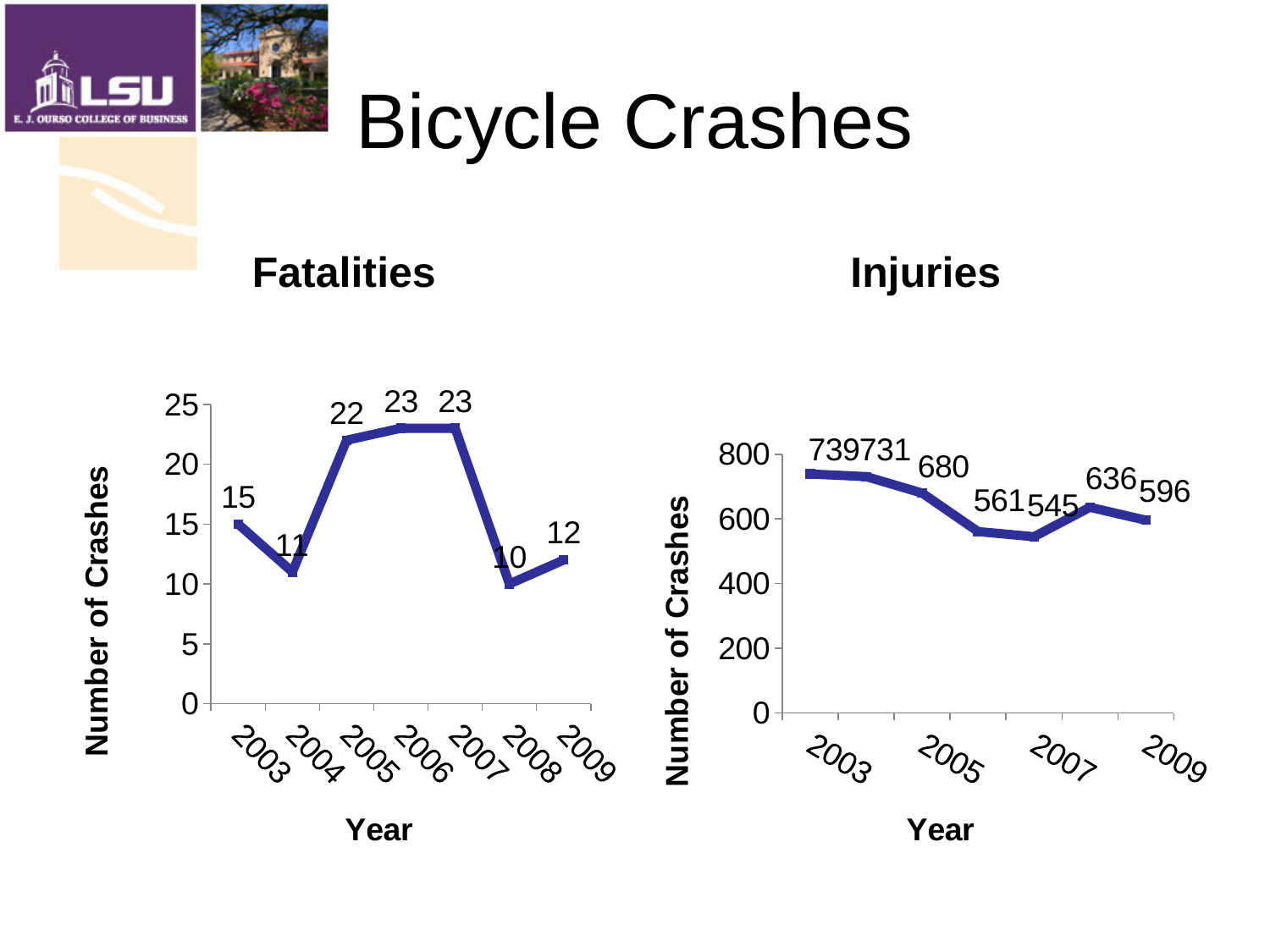
On the Fatalities chart, what is the difference between the number of crashes in 2006 and in 2008? 13 On the Fatalities chart, what is the number of crashes in 2008? 10 On the Fatalities chart, which year has the lowest number of crashes? 2008 On the Injuries chart, what is the number of crashes in 2009? 596 On the Fatalities chart, which year has more crashes, 2003 or 2009? 2003 On the Injuries chart, which year has the lowest number of crashes? 2007 On the Injuries chart, what is the difference between the number of crashes in 2003 and in 2009? 143 How many years are plotted on the Fatalities chart? 7 On the Injuries chart, what is the number of crashes in 2003? 739 What kind of chart is the Injuries chart? Line chart On the Fatalities chart, what is the number of crashes in 2005? 22 On the Injuries chart, which year has the highest number of crashes? 2003